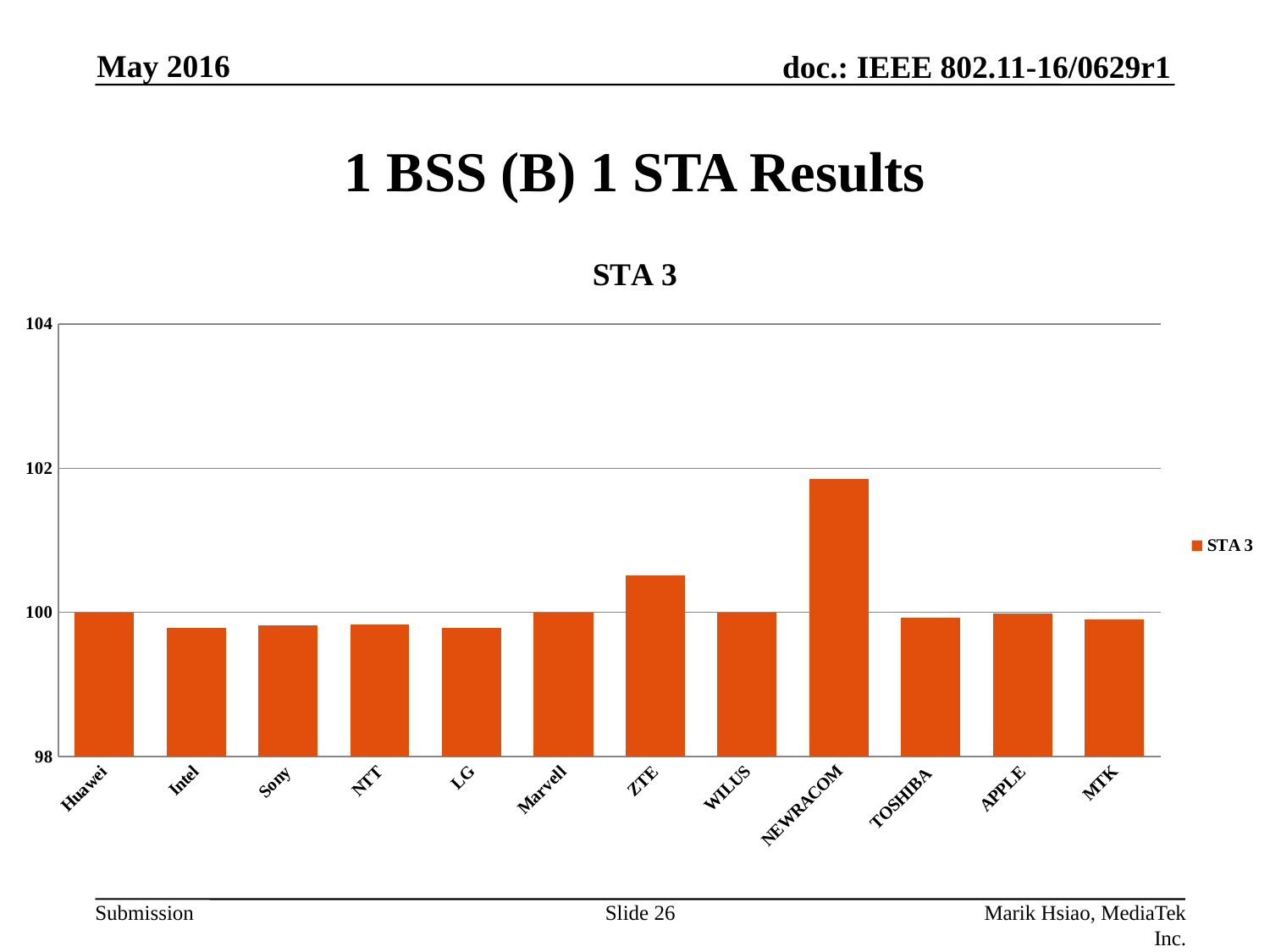
Is the value for Intel greater or less than 100? less What kind of chart is shown on the slide? bar chart Is the value for NEWRACOM greater or less than 100? greater What is the title of the chart? STA 3 Is the value for ZTE greater or less than 100? greater How many series does the legend list? 1 How many companies are shown on the x axis of the chart? 12 Which is larger, the value for ZTE or the value for LG? ZTE Which is larger, the value for NEWRACOM or the value for ZTE? NEWRACOM Which company has the highest value in the chart? NEWRACOM